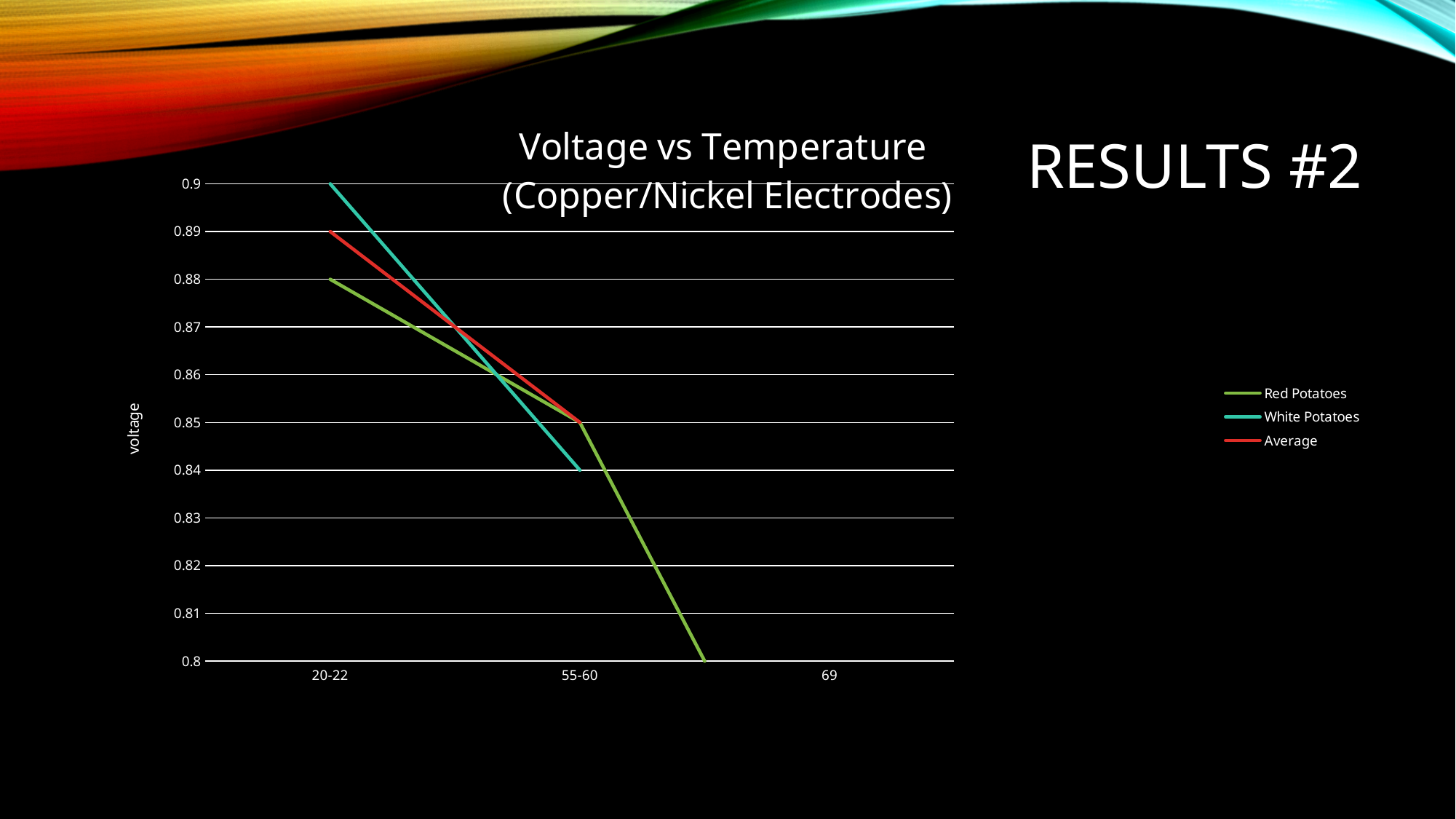
What is the voltage for White Potatoes at 20-22? 0.9 What is the label on the vertical axis? voltage Which series has the highest voltage at 20-22? White Potatoes Do the voltage values rise or fall as temperature increases along the x axis? fall What is the voltage for Red Potatoes at 20-22? 0.88 What kind of chart is shown on the slide? line chart What is the difference between the White Potatoes voltage at 20-22 and at 55-60? 0.06 How many series does the legend list? 3 At 55-60, which is higher: Red Potatoes or White Potatoes? Red Potatoes What is the voltage for Average at 55-60? 0.85 What is the voltage for White Potatoes at 55-60? 0.84 What is the voltage for Average at 20-22? 0.89